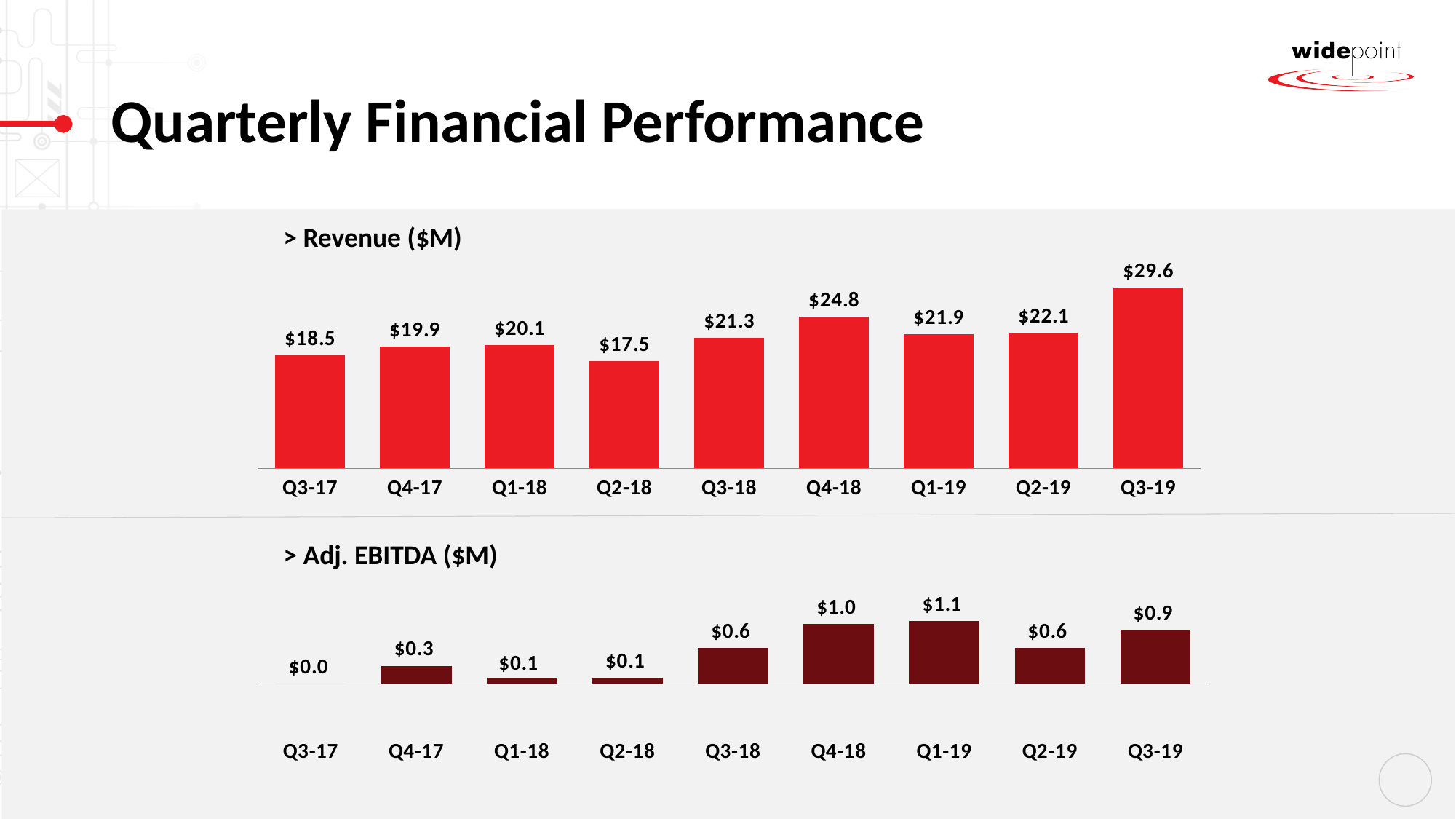
In the Revenue ($M) chart, which is larger, Q1-18 or Q4-17? Q1-18 In the Revenue ($M) chart, which quarter has the highest revenue? Q3-19 In the Revenue ($M) chart, what is the difference between Q3-19 and Q2-19? $7.5 In the Adj. EBITDA ($M) chart, what is the value for Q1-19? $1.1 What kind of chart is the Revenue ($M) chart? Bar chart In the Adj. EBITDA ($M) chart, which is larger, Q3-19 or Q2-19? Q3-19 In the Adj. EBITDA ($M) chart, what is the difference between Q4-18 and Q3-18? $0.4 In the Adj. EBITDA ($M) chart, which quarter has the lowest value? Q3-17 How many quarters are shown in the Revenue ($M) chart? 9 In the Revenue ($M) chart, which quarter has the lowest revenue? Q2-18 In the Revenue ($M) chart, what is the value for Q4-18? $24.8 What is the title of the lower chart on the slide? Adj. EBITDA ($M)